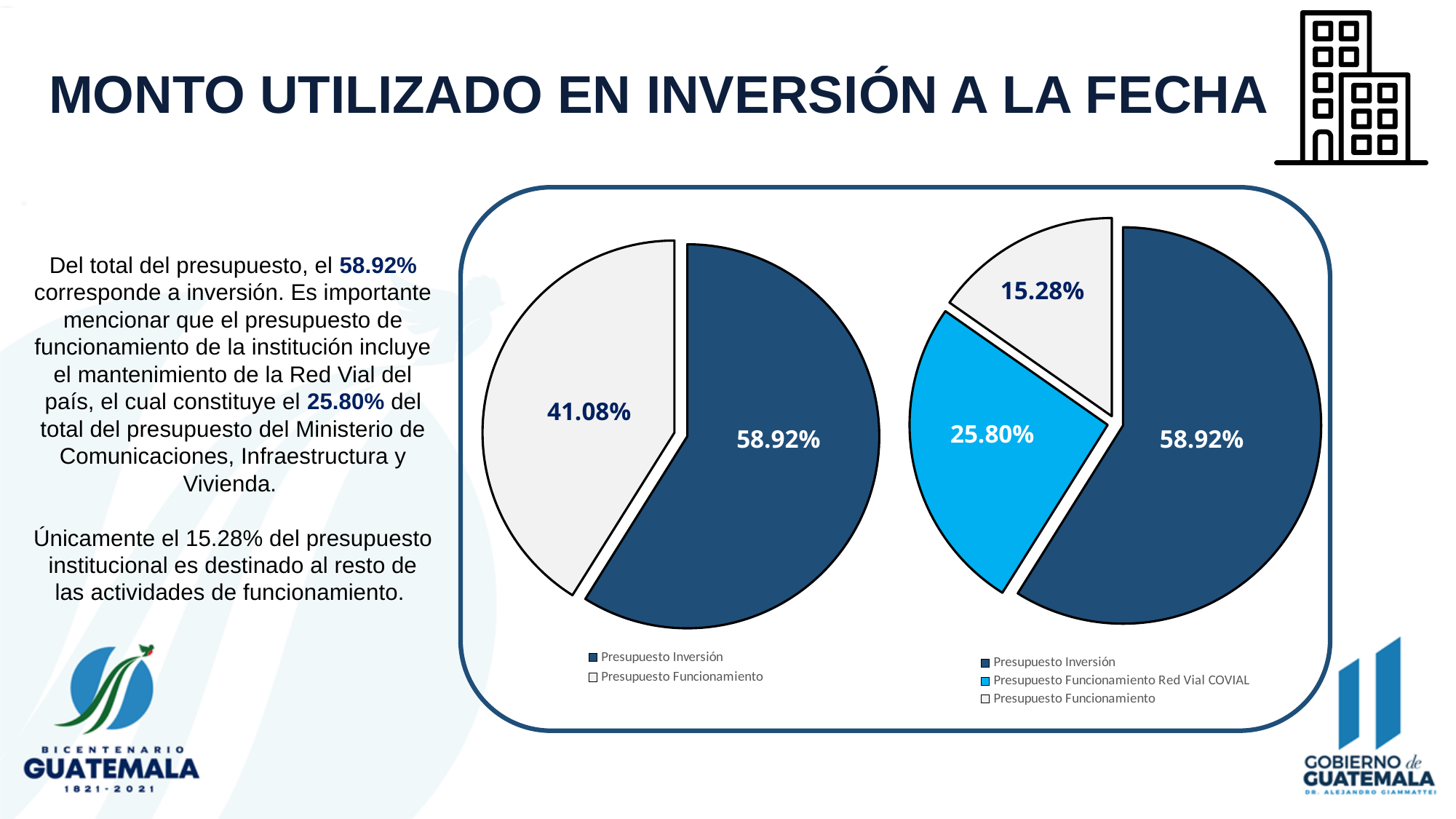
In the right pie chart, what share does Presupuesto Funcionamiento Red Vial COVIAL have? 25.80% In the right pie chart, which category has the smallest slice? Presupuesto Funcionamiento In the right pie chart, what share does Presupuesto Funcionamiento have? 15.28% What type of chart is shown on the left side of the box? Pie chart In the left pie chart, what share does Presupuesto Funcionamiento have? 41.08% How many slices does the right pie chart have? 3 In the right pie chart, which is larger: Presupuesto Funcionamiento Red Vial COVIAL or Presupuesto Funcionamiento? Presupuesto Funcionamiento Red Vial COVIAL How many entries does the legend of the left pie chart list? 2 In the left pie chart, what is the difference between the Presupuesto Inversión and Presupuesto Funcionamiento shares? 17.84% In the right pie chart, which category has the largest slice? Presupuesto Inversión In the left pie chart, what share does Presupuesto Inversión have? 58.92% In the right pie chart, what is the difference between the Presupuesto Funcionamiento Red Vial COVIAL and Presupuesto Funcionamiento shares? 10.52%